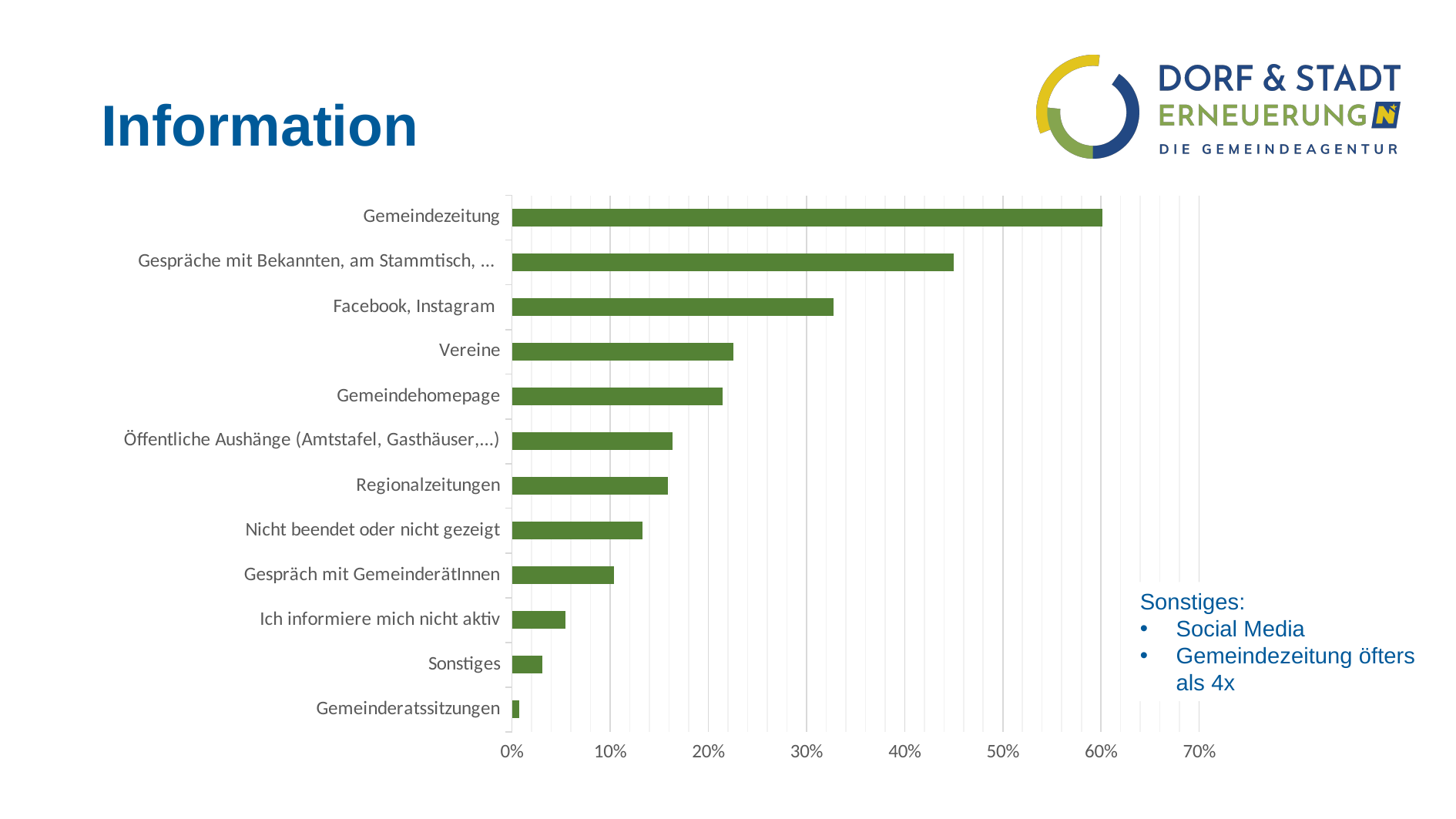
Which is larger, the value for Regionalzeitungen or the value for Sonstiges? Regionalzeitungen Is the value for Facebook, Instagram greater or less than 30%? greater Which is larger, the value for Gemeindezeitung or the value for Facebook, Instagram? Gemeindezeitung Is the value for Nicht beendet oder nicht gezeigt greater or less than 10%? greater How many categories are plotted in the chart? 12 Is the value for Gespräche mit Bekannten, am Stammtisch, ... greater or less than 40%? greater What is the title of the slide containing the chart? Information Which category has the lowest value in the chart? Gemeinderatssitzungen What kind of chart is shown on the slide? bar chart Which category has the highest value in the chart? Gemeindezeitung